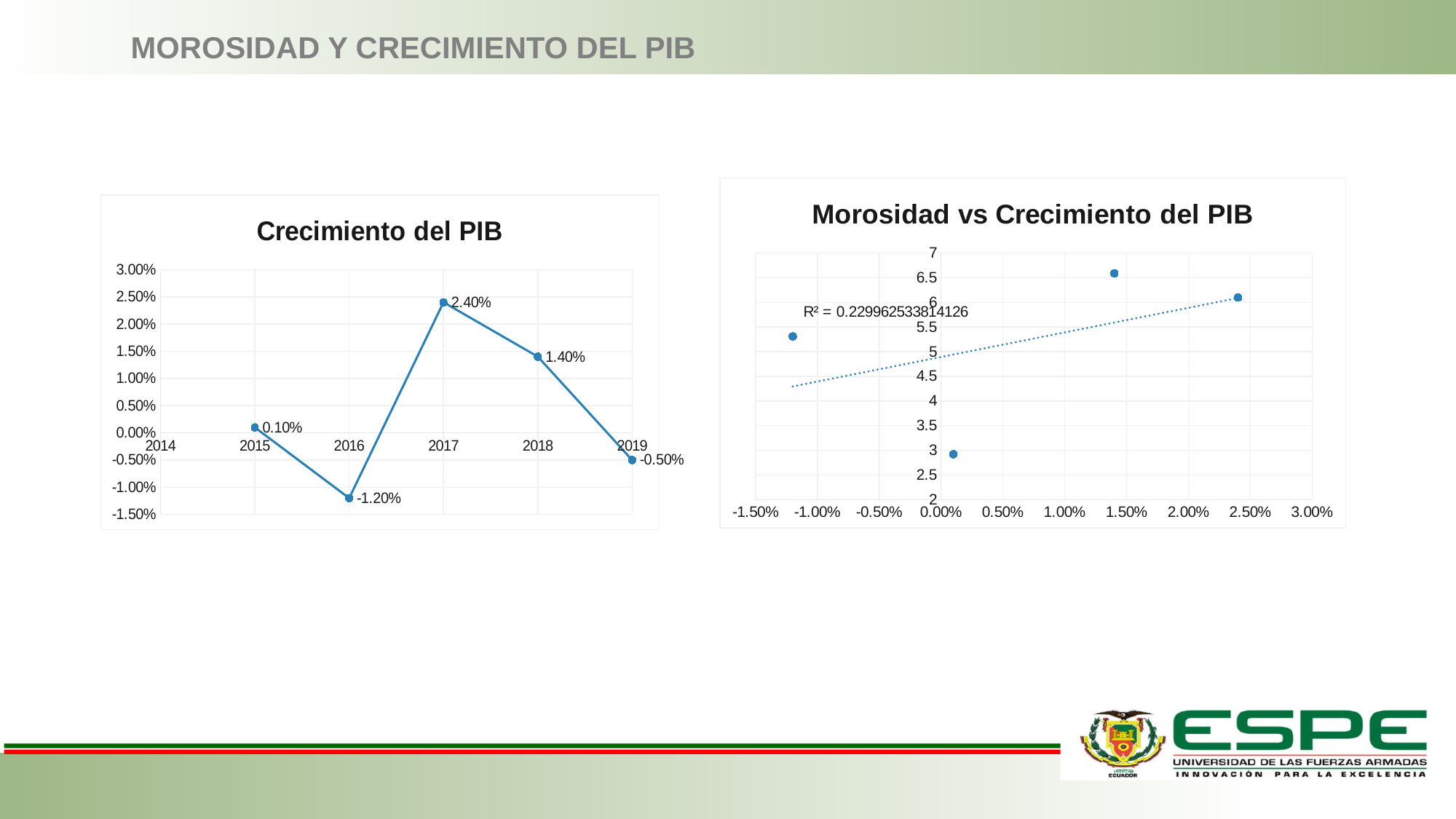
What kind of chart is the 'Morosidad vs Crecimiento del PIB' chart? scatter chart In the 'Crecimiento del PIB' chart, do the values rise or fall from 2017 to 2019? fall In the 'Crecimiento del PIB' chart, which year has the lowest value? 2016 In the 'Crecimiento del PIB' chart, which is larger, the value for 2015 or the value for 2018? 2018 In the 'Crecimiento del PIB' chart, how many data points are plotted? 5 In the 'Crecimiento del PIB' chart, what is the difference between the 2017 and 2018 values? 1.00% In the 'Morosidad vs Crecimiento del PIB' chart, what R² value is shown? 0.229962533814126 What kind of chart is the 'Crecimiento del PIB' chart? line chart In the 'Crecimiento del PIB' chart, which year has the highest value? 2017 In the 'Crecimiento del PIB' chart, what is the value for 2019? -0.50% In the 'Crecimiento del PIB' chart, what is the value for 2017? 2.40% In the 'Crecimiento del PIB' chart, what is the value for 2016? -1.20%